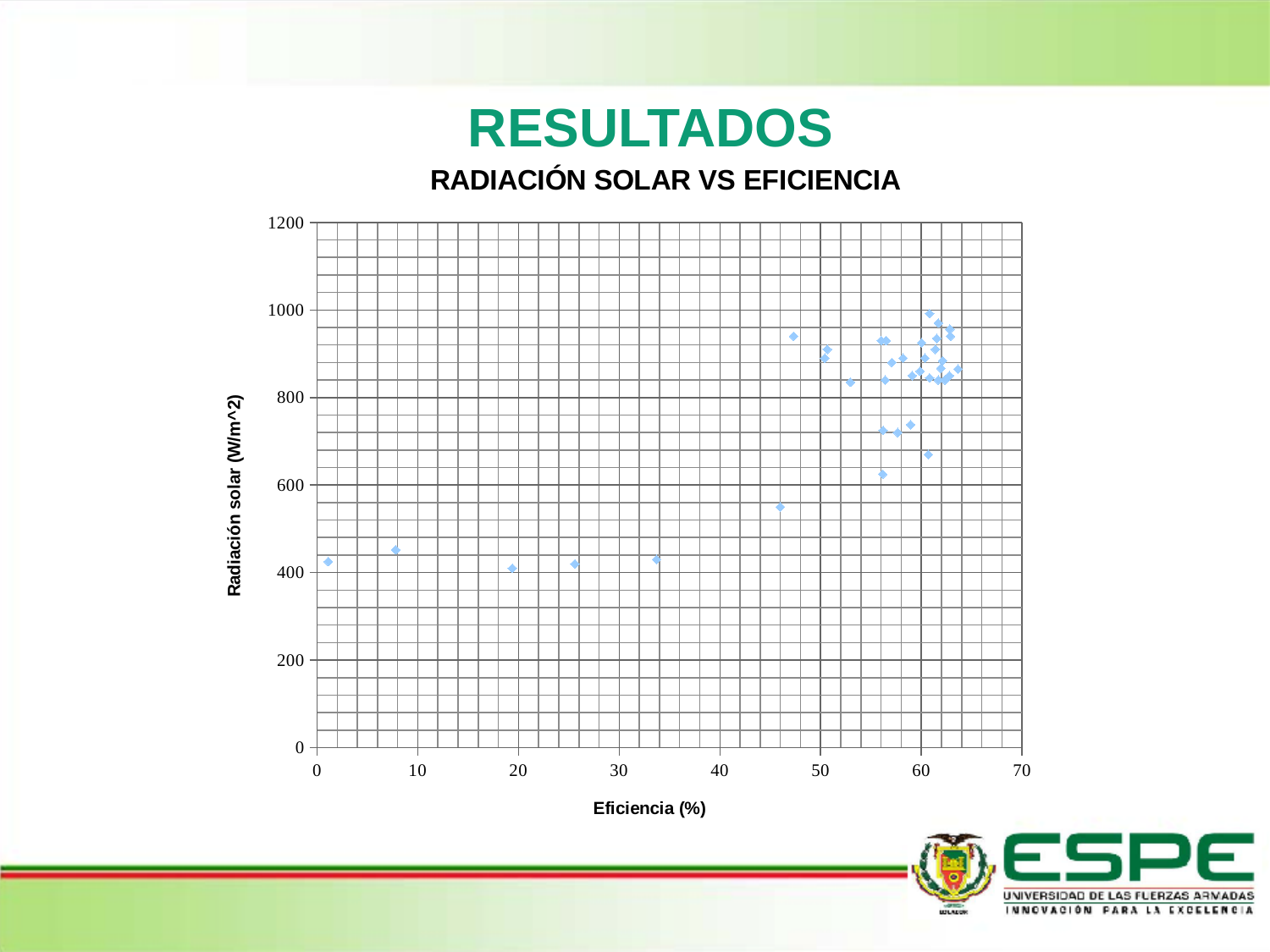
Is the solar radiation for the point at about 47% efficiency greater or less than 800 W/m^2? greater Is the solar radiation for the point at about 1% efficiency greater or less than 600 W/m^2? less Is the solar radiation for the point at about 46% efficiency greater or less than 800 W/m^2? less What kind of chart is shown on the slide? Scatter chart Overall, does solar radiation tend to rise or fall as efficiency increases along the x axis? rise What is the title of the chart? RADIACIÓN SOLAR VS EFICIENCIA What is the label of the vertical axis of the chart? Radiación solar (W/m^2) Which has higher solar radiation: the point at about 8% efficiency or the point at about 47% efficiency? The point at about 47% efficiency What is the highest value shown on the horizontal axis (Eficiencia) of the chart? 70 What is the highest value shown on the vertical axis of the chart? 1200 In which efficiency range are most of the data points clustered: below 40% or above 50%? above 50%